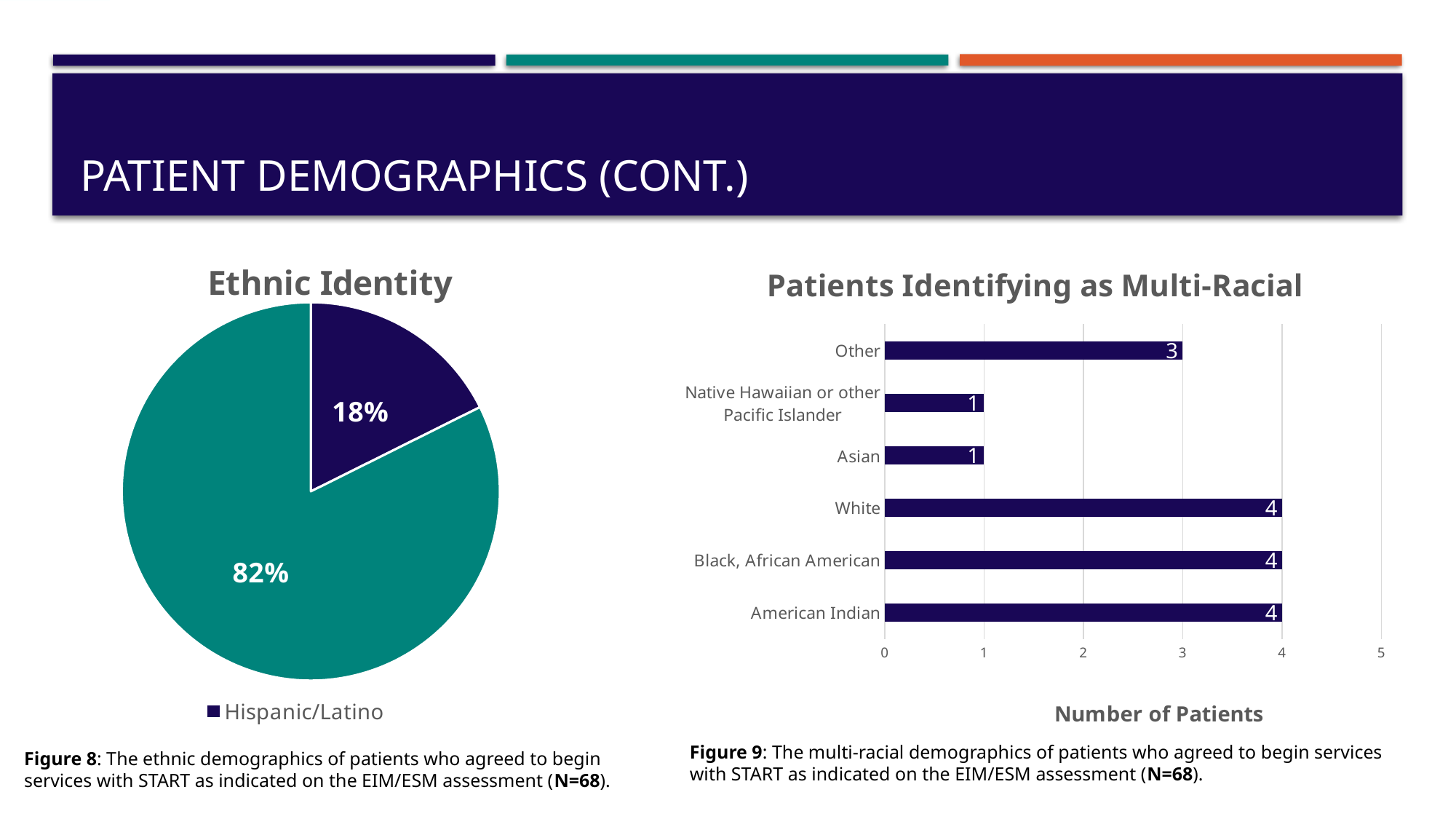
In the 'Patients Identifying as Multi-Racial' chart, how many patients identify as White? 4 In the 'Patients Identifying as Multi-Racial' chart, what is the difference between the values for Other and Asian? 2 In the 'Patients Identifying as Multi-Racial' chart, how many patients are in the 'Other' category? 3 What kind of chart is the 'Patients Identifying as Multi-Racial' chart? bar chart In the 'Ethnic Identity' chart, what percentage of patients are Hispanic/Latino? 18% In the 'Ethnic Identity' chart, what percentage does the larger teal slice represent? 82% In the 'Patients Identifying as Multi-Racial' chart, which is larger: the value for Other or the value for Native Hawaiian or other Pacific Islander? Other What kind of chart is the 'Ethnic Identity' chart? pie chart In the 'Patients Identifying as Multi-Racial' chart, how many categories are shown? 6 In the 'Patients Identifying as Multi-Racial' chart, how many patients identify as Asian? 1 In the 'Ethnic Identity' chart, which entry does the legend list? Hispanic/Latino In the 'Patients Identifying as Multi-Racial' chart, what is the label of the x axis? Number of Patients